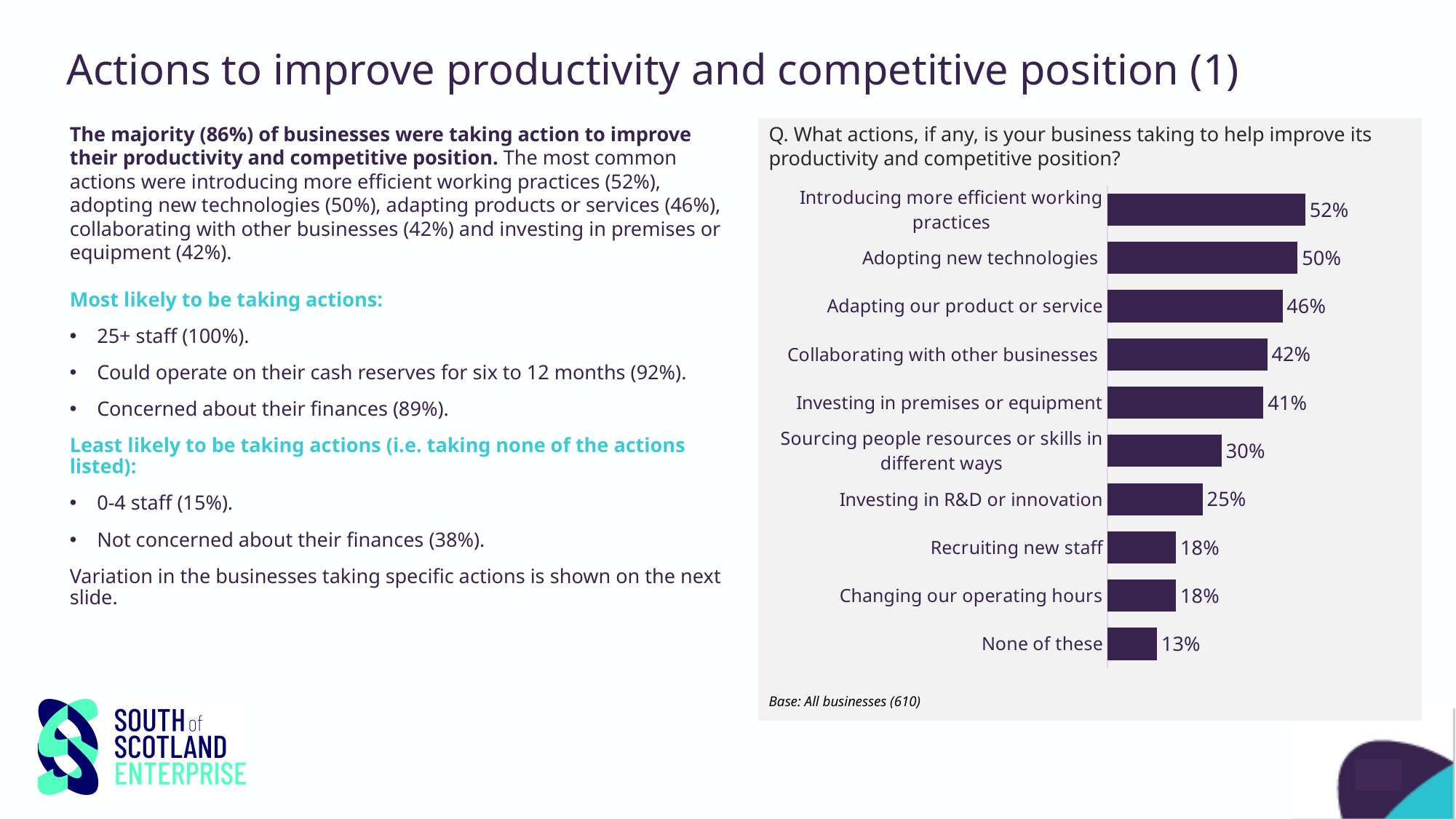
What is the base (number of respondents) stated below the chart? All businesses (610) What type of chart is used on the slide? Bar chart Which action has the highest percentage in the chart? Introducing more efficient working practices Which two categories share the same value of 18%? Recruiting new staff and Changing our operating hours What is the difference in percentage points between 'Adopting new technologies' and 'Adapting our product or service'? 4 percentage points What is the difference between 'Collaborating with other businesses' and 'Investing in premises or equipment'? 1 percentage point How many categories are shown in the bar chart? 10 Which category has the lowest value in the chart? None of these What percentage of businesses selected 'None of these'? 13% What percentage of businesses reported introducing more efficient working practices? 52% Which is larger: 'Sourcing people resources or skills in different ways' or 'Investing in R&D or innovation'? Sourcing people resources or skills in different ways What is the value shown for 'Investing in R&D or innovation'? 25%